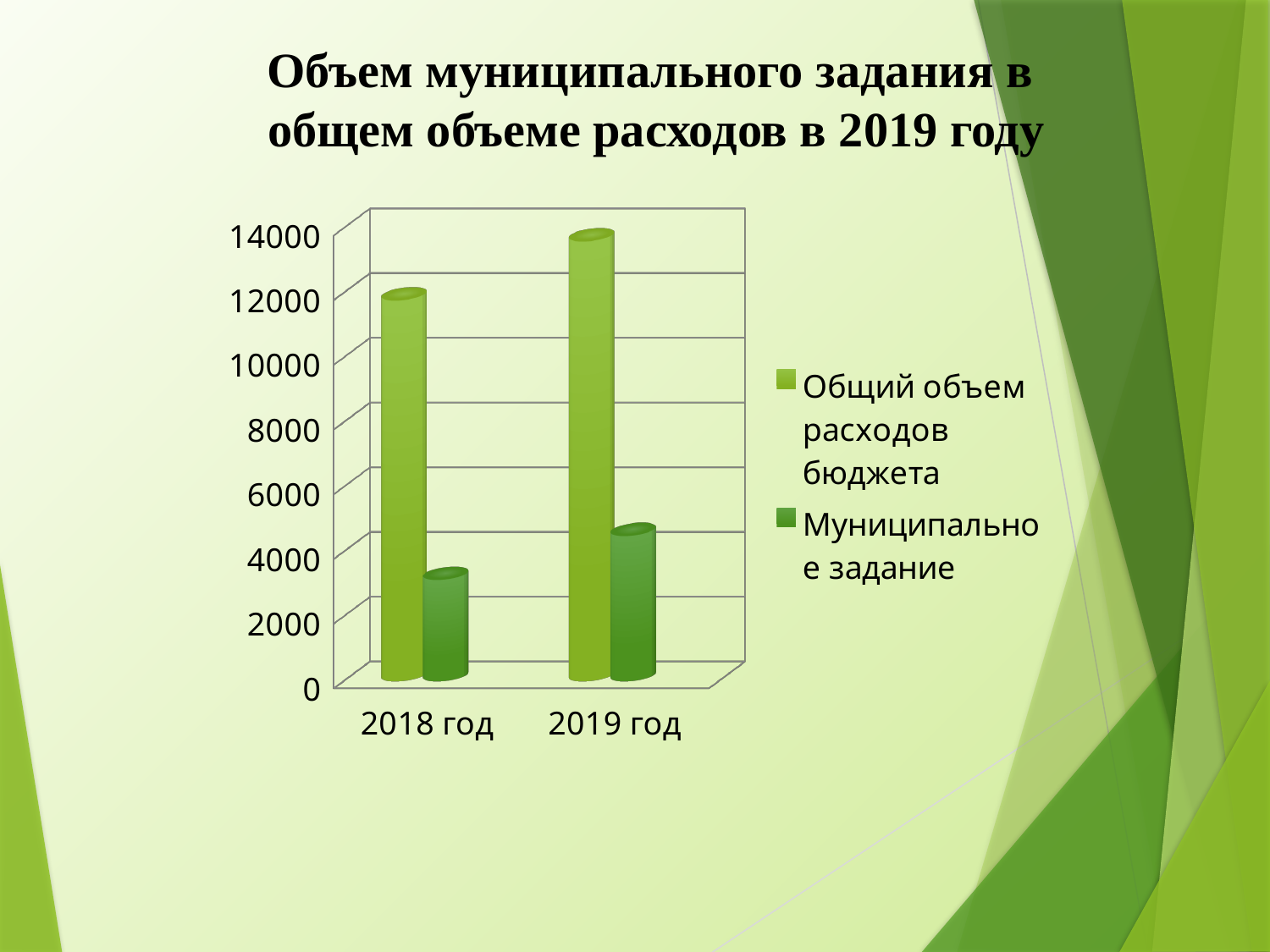
In 2019 год, which is larger: Общий объем расходов бюджета or Муниципальное задание? Общий объем расходов бюджета Is the value for Общий объем расходов бюджета in 2018 год greater or less than 10000? greater How many series does the chart legend list? 2 Is the value for Муниципальное задание in 2019 год greater or less than 6000? less Is the value for Муниципальное задание in 2018 год greater or less than 4000? less In which year is the value for Общий объем расходов бюджета higher? 2019 год What is the title of the chart on the slide? Объем муниципального задания в общем объеме расходов в 2019 году Does the value for Муниципальное задание rise or fall from 2018 год to 2019 год? rise What are the two series named in the chart legend? Общий объем расходов бюджета; Муниципальное задание What kind of chart is shown on the slide? bar chart How many categories (years) are shown on the x axis of the chart? 2